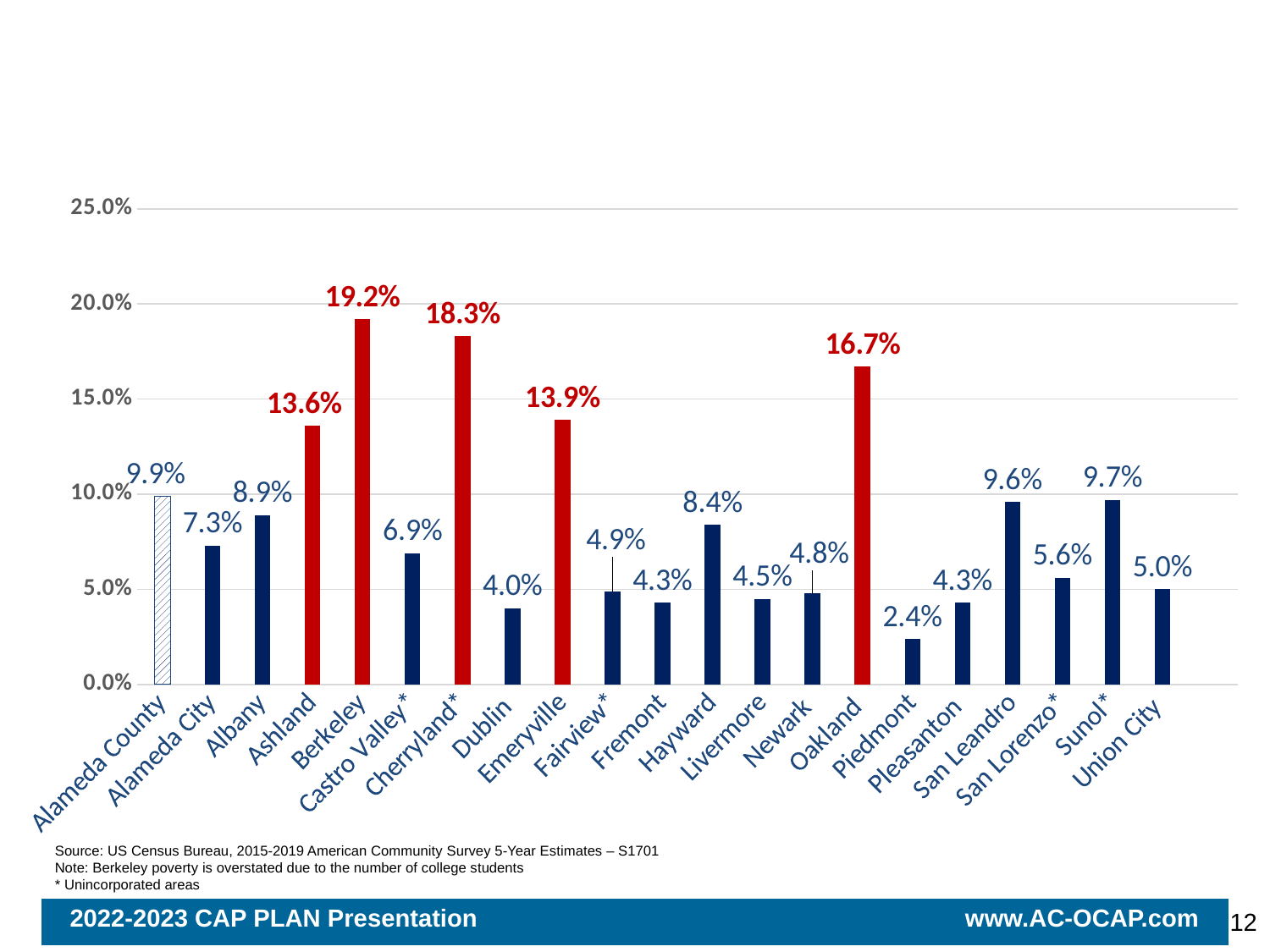
What is the value shown for Alameda County? 9.9% How many categories are shown on the x axis? 21 What is the value shown for Piedmont? 2.4% What is the value shown for Berkeley? 19.2% What is the difference between the values for Oakland and Alameda County? 6.8% What kind of chart is shown on the slide? bar chart Is the value for Oakland greater or less than 15.0%? greater What is the value shown for San Lorenzo*? 5.6% Which category has the lowest value? Piedmont Which has a larger value, Albany or Hayward? Albany Which category has the highest value? Berkeley What is the difference between the values for Berkeley and Cherryland*? 0.9%